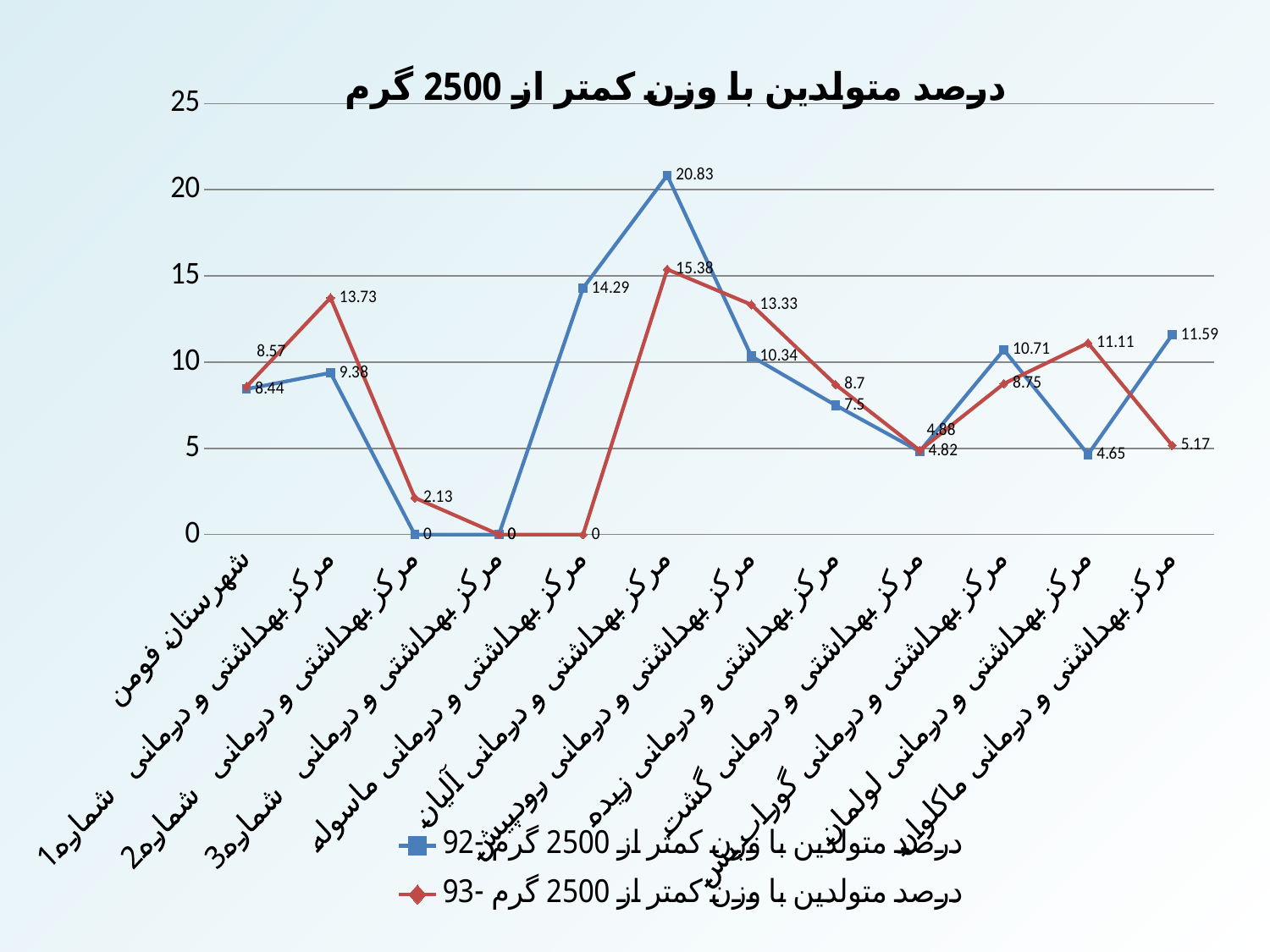
How many categories are plotted along the x axis? 12 What is the title of the chart? درصد متولدین با وزن کمتر از 2500 گرم What is the value of the 93 series for مرکز بهداشتی و درمانی شماره1? 13.73 For مرکز بهداشتی و درمانی لولمان, which series has the larger value, 92 or 93? 93 How many series does the legend list? 2 Which category has the highest value in the 92 series? مرکز بهداشتی و درمانی آلیان What is the difference between the 92 and 93 values for مرکز بهداشتی و درمانی آلیان? 5.45 What is the value of the 93 series for مرکز بهداشتی و درمانی ماسوله? 0 What is the value of the 92 series for مرکز بهداشتی و درمانی آلیان? 20.83 Is the 92 value for مرکز بهداشتی و درمانی ماسوله greater or less than 10? greater Which category has the highest value in the 93 series? مرکز بهداشتی و درمانی آلیان What kind of chart is shown on the slide? Line chart